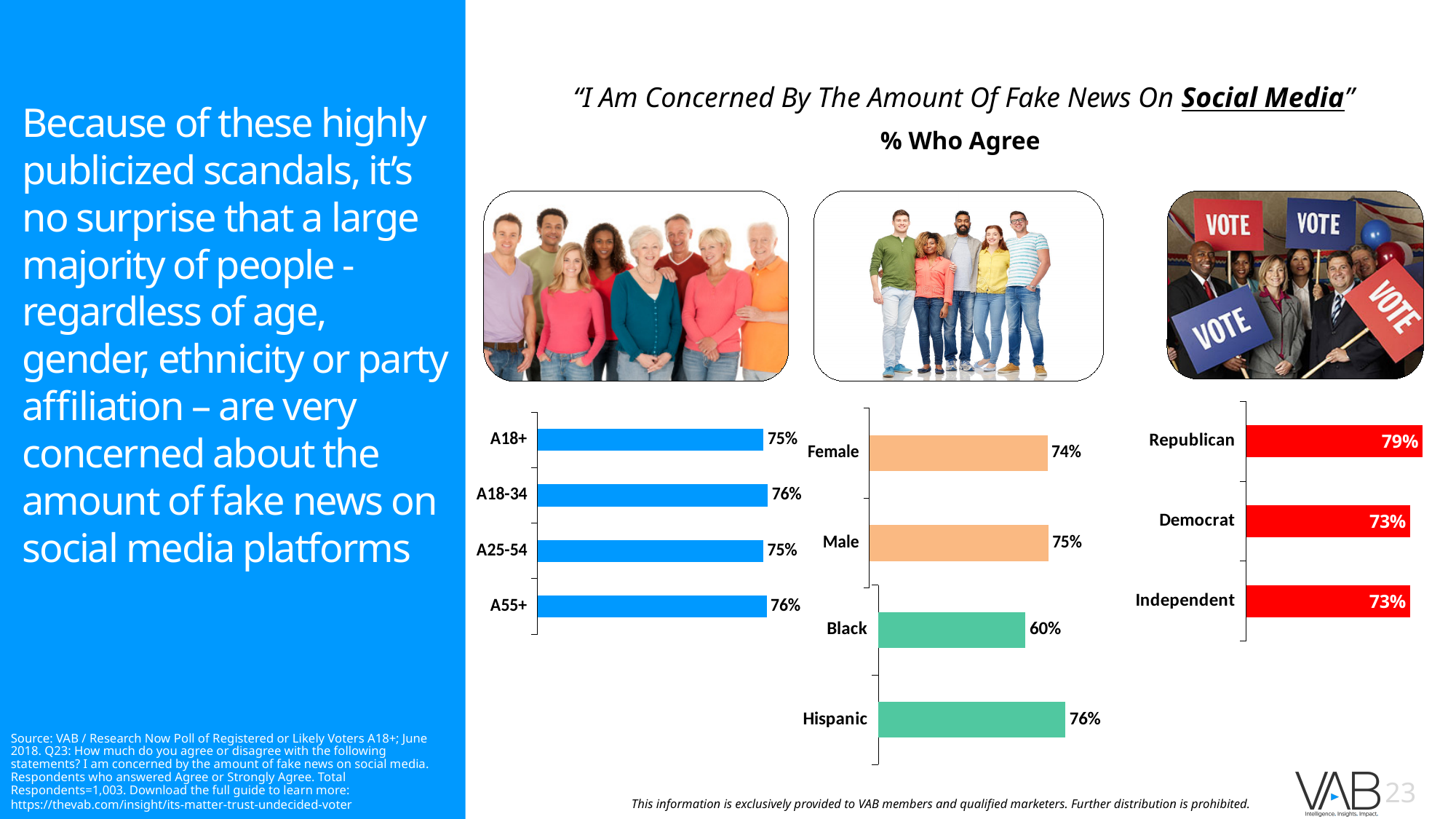
In the ethnicity bar chart in the middle, what is the difference between the Hispanic and Black percentages? 16% In the party affiliation bar chart on the right, what is the difference between the Republican and Democrat percentages? 6% How many age categories are shown in the age-group bar chart on the left? 4 In the age-group bar chart on the left, what percentage of A18-34 agree? 76% In the ethnicity bar chart in the middle, what percentage of Black respondents agree? 60% What type of chart is used to show the party affiliation data on the right? Bar chart In the age-group bar chart on the left, what percentage of A25-54 agree? 75% In the party affiliation bar chart on the right, which party has the highest percentage who agree? Republican In the ethnicity bar chart in the middle, which group has the lowest percentage who agree? Black What colour are the bars in the party affiliation chart on the right? Red In the gender bar chart in the middle, which is larger, the Male or Female percentage? Male In the gender bar chart in the middle, what percentage of Female respondents agree? 74%